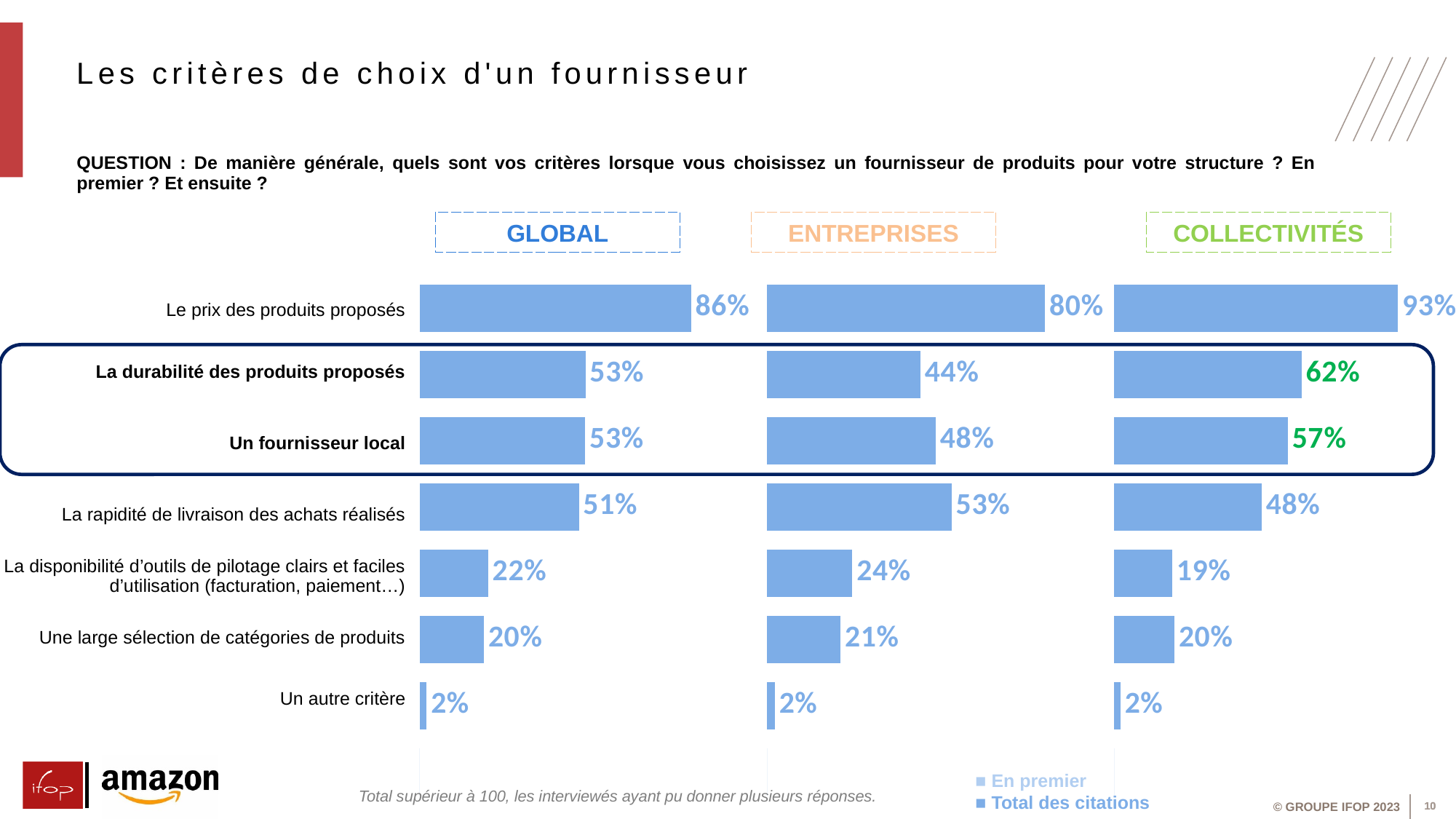
In the ENTREPRISES chart, which criterion has the lowest value? Un autre critère What are the two entries listed in the legend at the bottom right of the slide? En premier; Total des citations In the COLLECTIVITÉS chart, what is the value for "La durabilité des produits proposés"? 62% How many criteria (categories) are shown in the GLOBAL chart? 7 In the COLLECTIVITÉS chart, which criterion has the highest value? Le prix des produits proposés In the GLOBAL chart, what is the value for "La disponibilité d'outils de pilotage clairs et faciles d'utilisation (facturation, paiement…)"? 22% For "Un fournisseur local", which chart shows the larger value: ENTREPRISES or COLLECTIVITÉS? COLLECTIVITÉS In the GLOBAL chart, what is the difference between "Le prix des produits proposés" and "La durabilité des produits proposés"? 33 percentage points In the GLOBAL chart, what is the value for "Le prix des produits proposés"? 86% What type of chart is used for the GLOBAL, ENTREPRISES and COLLECTIVITÉS data? Bar chart In the ENTREPRISES chart, what is the value for "Un fournisseur local"? 48% In the ENTREPRISES chart, which is larger: "La rapidité de livraison des achats réalisés" or "La durabilité des produits proposés"? La rapidité de livraison des achats réalisés